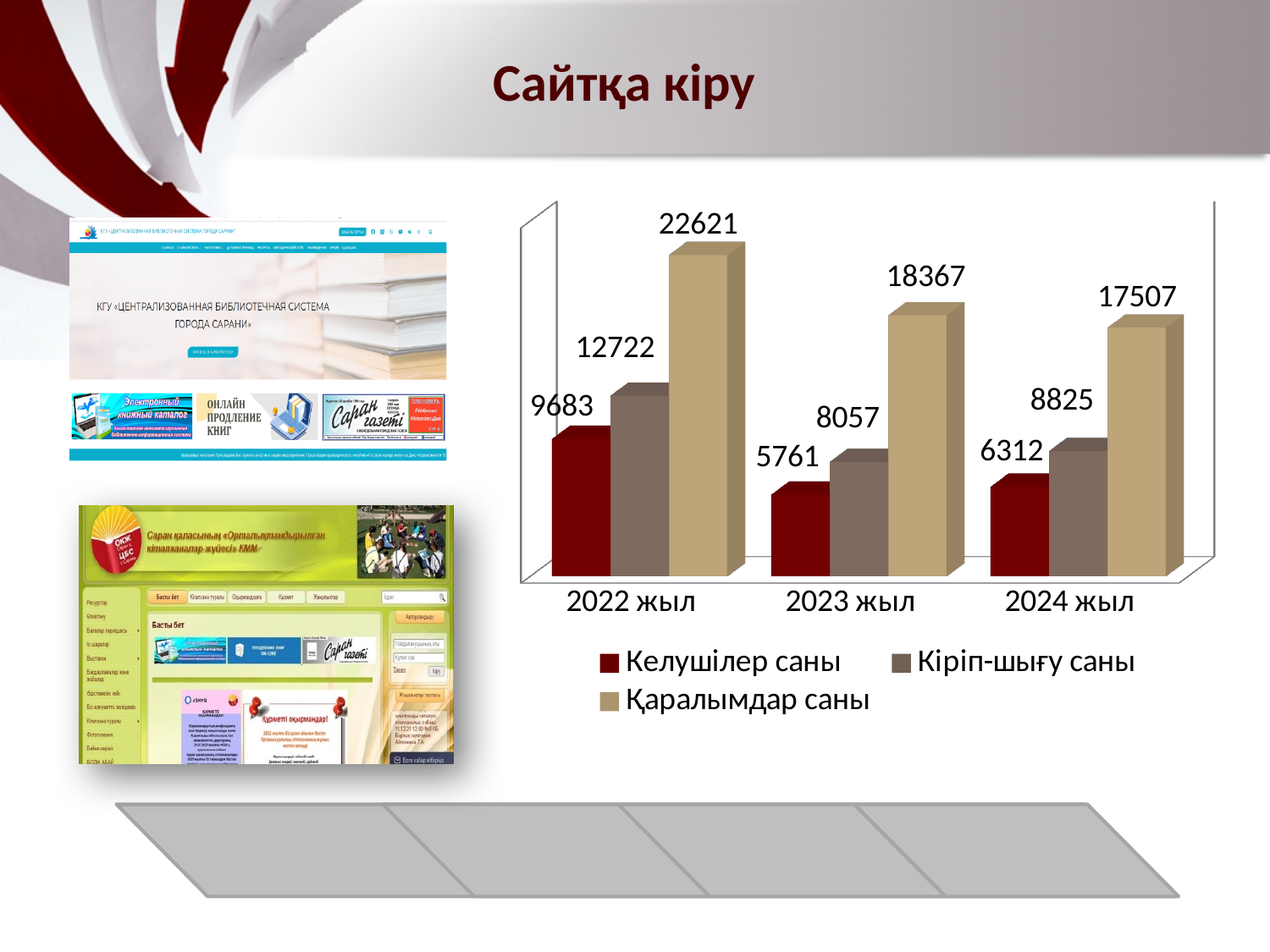
In which year is Қаралымдар саны highest? 2022 жыл What is the value of Қаралымдар саны for 2023 жыл? 18367 What kind of chart is shown on the slide? Bar chart What is the value of Келушілер саны for 2022 жыл? 9683 Which is larger: Келушілер саны in 2024 жыл or Келушілер саны in 2023 жыл? 2024 жыл Does Қаралымдар саны rise or fall from 2022 жыл to 2024 жыл? Fall What is the value of Кіріп-шығу саны for 2024 жыл? 8825 What is the difference between Кіріп-шығу саны and Келушілер саны in 2023 жыл? 2296 In which year is Келушілер саны lowest? 2023 жыл How many years are shown on the x axis of the chart? 3 How many series does the chart legend list? 3 What is the difference between Қаралымдар саны in 2022 жыл and 2024 жыл? 5114